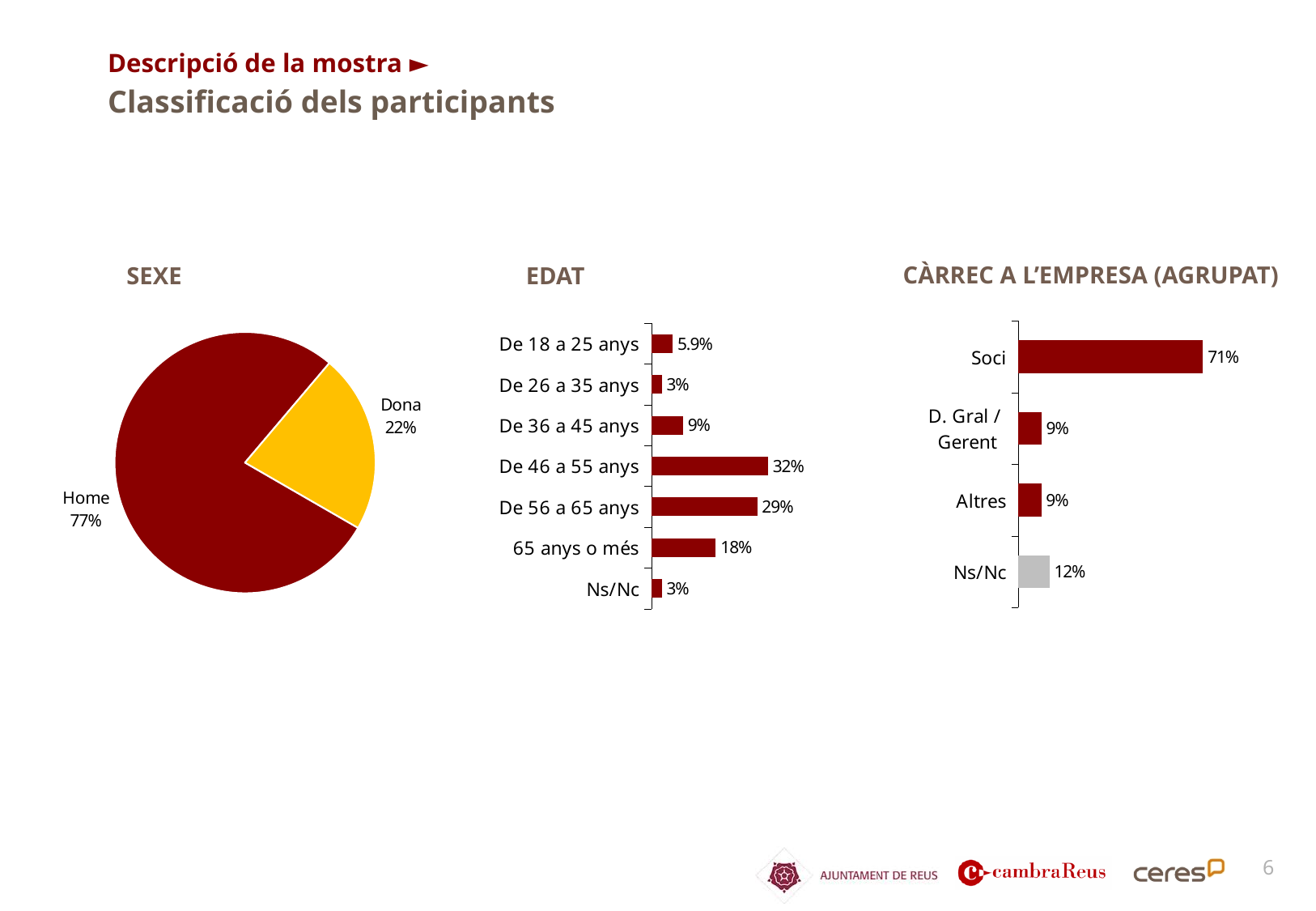
In the EDAT chart, what is the value for De 18 a 25 anys? 5.9% In the EDAT chart, which age group has the highest value? De 46 a 55 anys In the CÀRREC A L'EMPRESA (AGRUPAT) chart, which is larger, Ns/Nc or Altres? Ns/Nc What kind of chart is the SEXE chart? Pie chart In the CÀRREC A L'EMPRESA (AGRUPAT) chart, which category has the highest value? Soci What kind of chart is the EDAT chart? Bar chart In the SEXE chart, what share of participants are Dona? 22% In the EDAT chart, what is the difference between De 46 a 55 anys and De 56 a 65 anys? 3% How many categories does the EDAT chart show? 7 In the EDAT chart, what is the value for De 46 a 55 anys? 32% In the CÀRREC A L'EMPRESA (AGRUPAT) chart, what is the value for Soci? 71% In the SEXE chart, what share of participants are Home? 77%